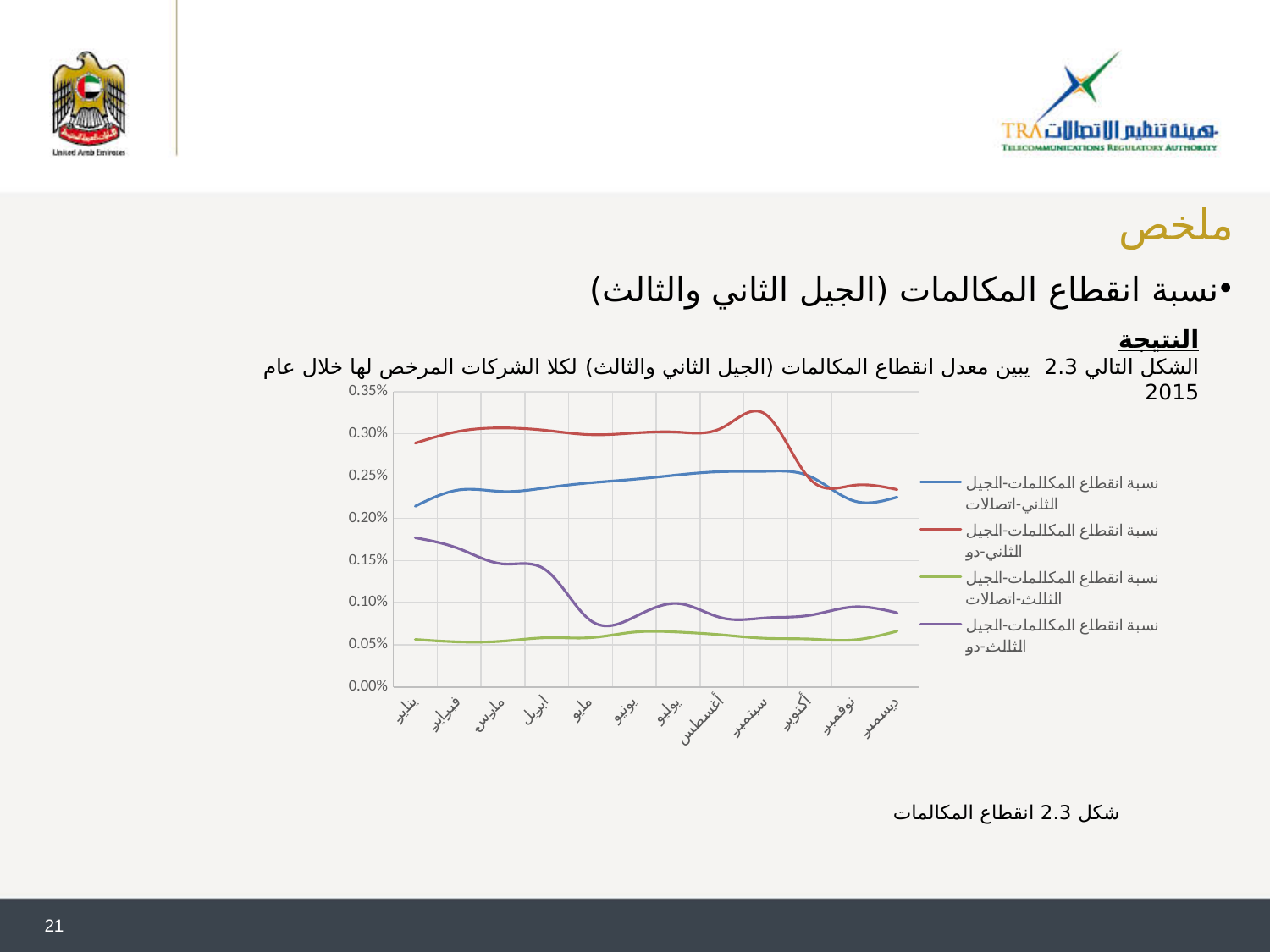
Is the value of the series نسبة انقطاع المكالمات-الجيل الثاني-اتصالات in يناير greater or less than 0.25%? less Which series reaches the highest value on the chart? نسبة انقطاع المكالمات-الجيل الثاني-دو In يناير, which series has the larger value: نسبة انقطاع المكالمات-الجيل الثالث-دو or نسبة انقطاع المكالمات-الجيل الثالث-اتصالات? نسبة انقطاع المكالمات-الجيل الثالث-دو Is the value of the series نسبة انقطاع المكالمات-الجيل الثالث-دو in يناير greater or less than 0.15%? greater In يناير, which series has the larger value: نسبة انقطاع المكالمات-الجيل الثاني-دو or نسبة انقطاع المكالمات-الجيل الثاني-اتصالات? نسبة انقطاع المكالمات-الجيل الثاني-دو Is the value of the series نسبة انقطاع المكالمات-الجيل الثالث-اتصالات in ديسمبر greater or less than 0.10%? less How many series does the chart's legend list? 4 How many months are plotted along the x axis of the chart? 12 Does the series نسبة انقطاع المكالمات-الجيل الثالث-دو rise or fall from يناير to مايو? fall Which series has the lowest values across the year on the chart? نسبة انقطاع المكالمات-الجيل الثالث-اتصالات What kind of chart is shown on the slide? line chart